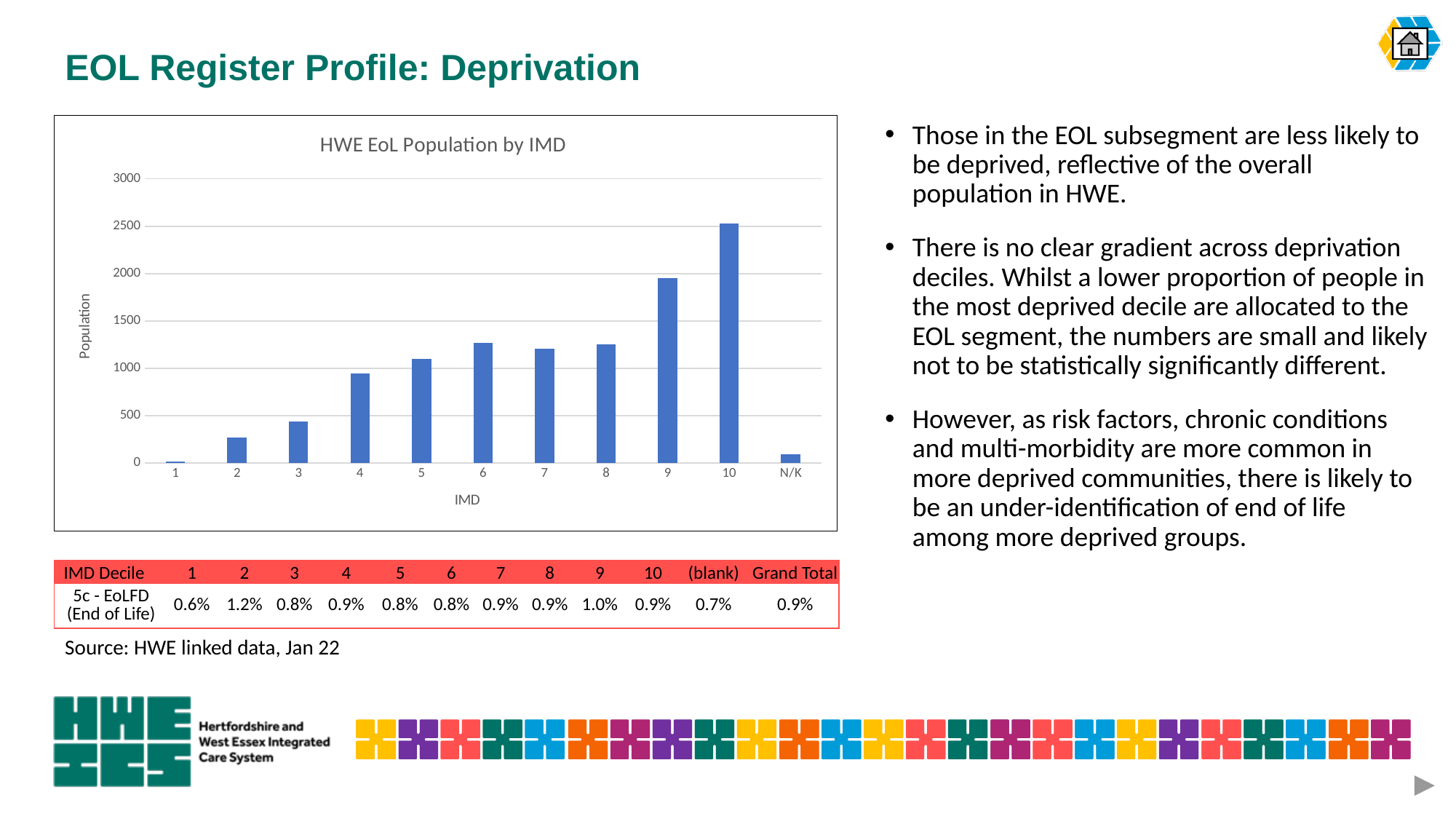
Is the value for IMD 5 greater or less than 1000? greater What is the title of the chart? HWE EoL Population by IMD Which has a larger population, IMD 3 or IMD 4? 4 How many categories are shown on the x axis of the chart? 11 What is the label on the y axis of the chart? Population Is the value for IMD 9 greater or less than 2000? less Is the value for IMD 10 greater or less than 2500? greater Which IMD category has the lowest population in the chart? 1 Which IMD category has the highest population in the chart? 10 What kind of chart is shown on the slide? bar chart Which has a larger population, IMD 9 or IMD 10? 10